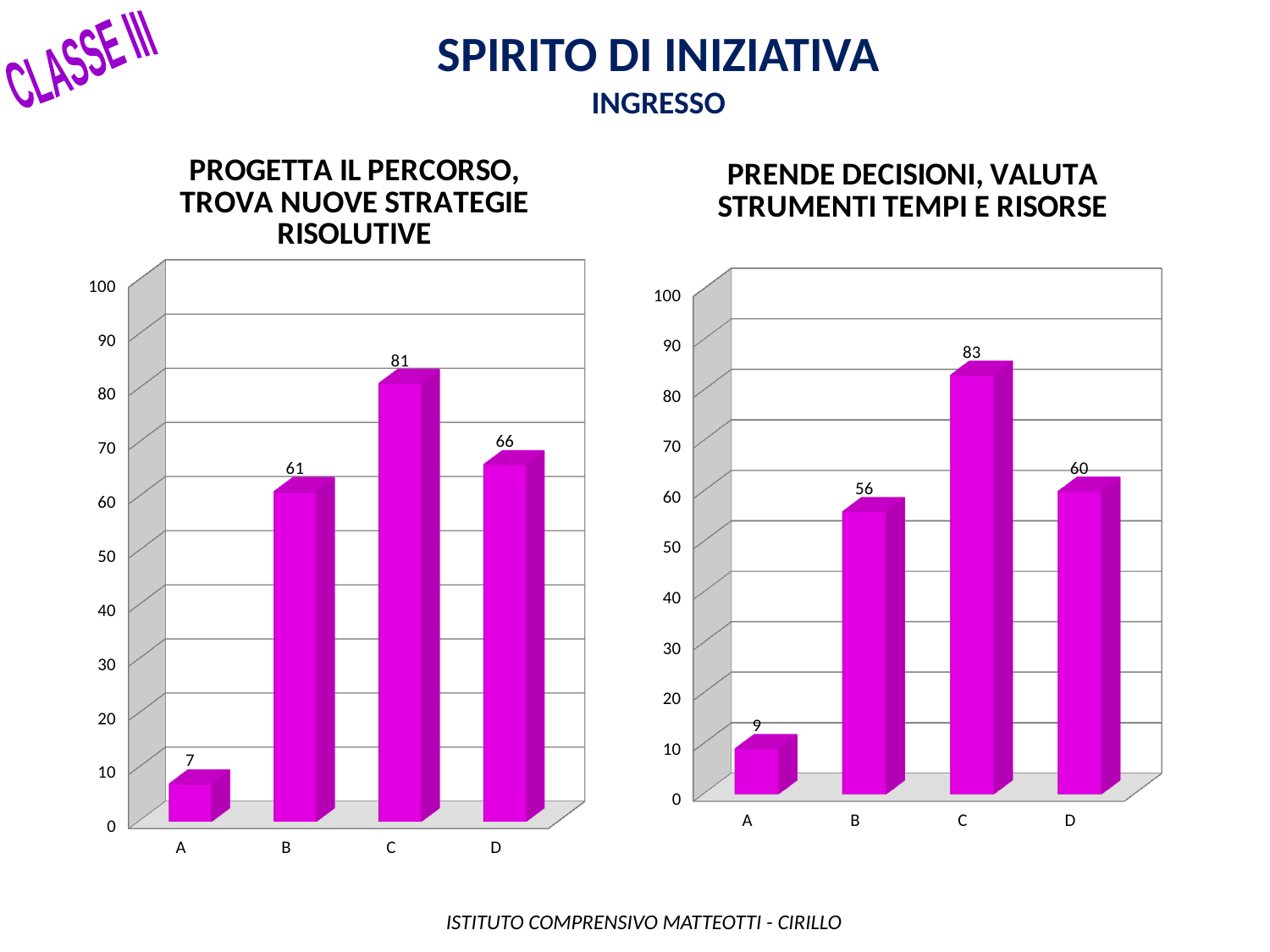
In the left chart (PROGETTA IL PERCORSO), what is the value for category B? 61 In the right chart (PRENDE DECISIONI), which category has the highest value? C What kind of chart is the left chart (PROGETTA IL PERCORSO)? bar chart In the left chart (PROGETTA IL PERCORSO), is the value for D greater or less than 70? less In the left chart (PROGETTA IL PERCORSO), what is the difference between the values for C and B? 20 In the right chart (PRENDE DECISIONI), what is the difference between the values for C and D? 23 What is the main title of the slide? SPIRITO DI INIZIATIVA In the right chart (PRENDE DECISIONI, VALUTA STRUMENTI TEMPI E RISORSE), what is the value for category A? 9 In the left chart (PROGETTA IL PERCORSO, TROVA NUOVE STRATEGIE RISOLUTIVE), what is the value for category C? 81 In the right chart (PRENDE DECISIONI), which is larger, the value for B or the value for D? D How many categories are shown in the right chart (PRENDE DECISIONI)? 4 In the left chart (PROGETTA IL PERCORSO), which category has the lowest value? A